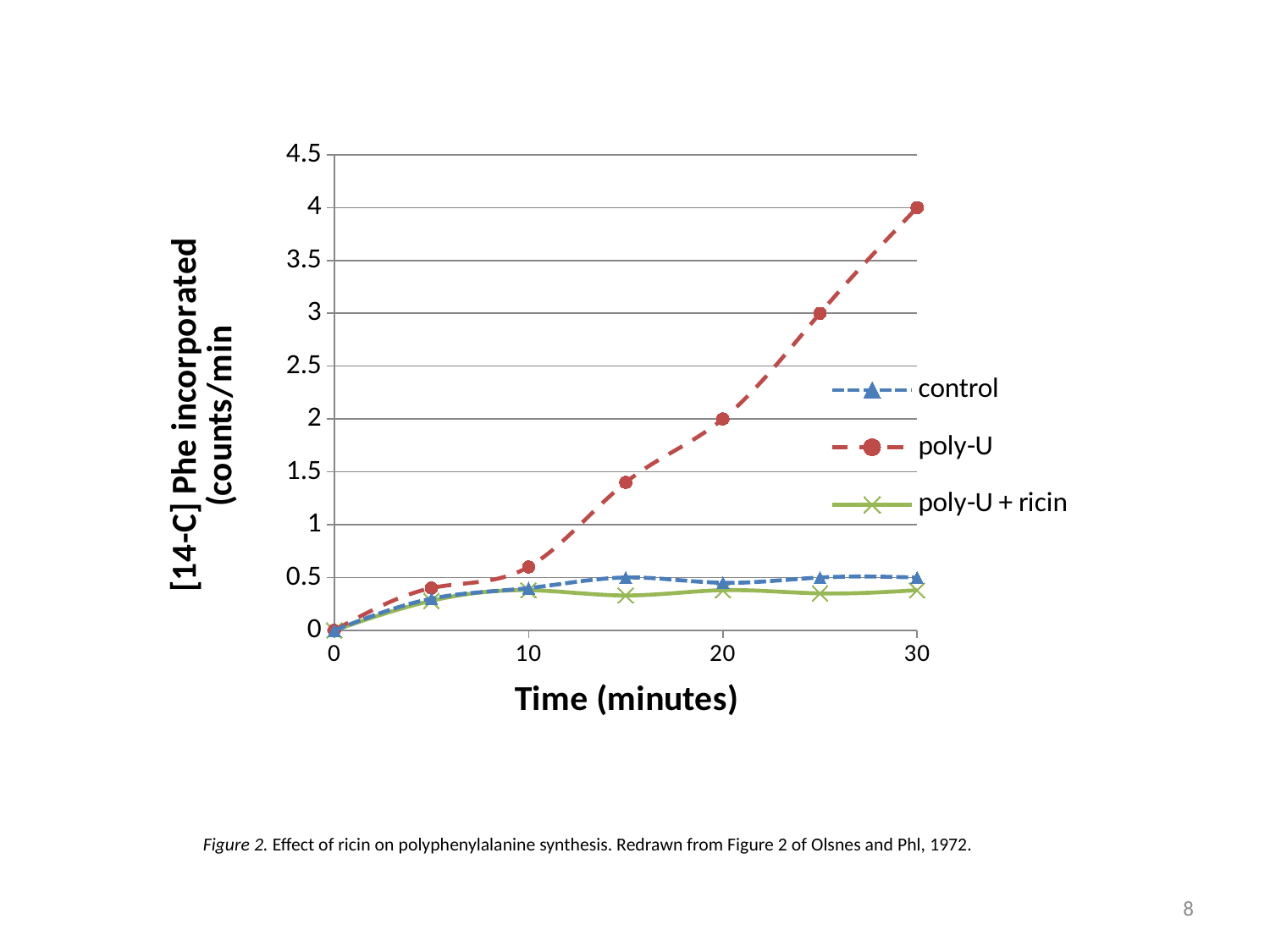
Does the poly-U series rise or fall as time increases from 0 to 30 minutes? rise What kind of chart is shown on the slide? line chart What is the difference between the poly-U values at 30 minutes and 20 minutes? 2 Is the value for poly-U at 15 minutes greater or less than 1? greater What is the value for poly-U at 30 minutes? 4 At 30 minutes, which is larger: poly-U or poly-U + ricin? poly-U Is the value for control at 30 minutes greater or less than 1? less What is the value for poly-U at 20 minutes? 2 Is the value for poly-U + ricin at 20 minutes greater or less than 0.5? less What is the value for poly-U at 25 minutes? 3 Which series has the highest value at 30 minutes? poly-U How many series does the legend list? 3